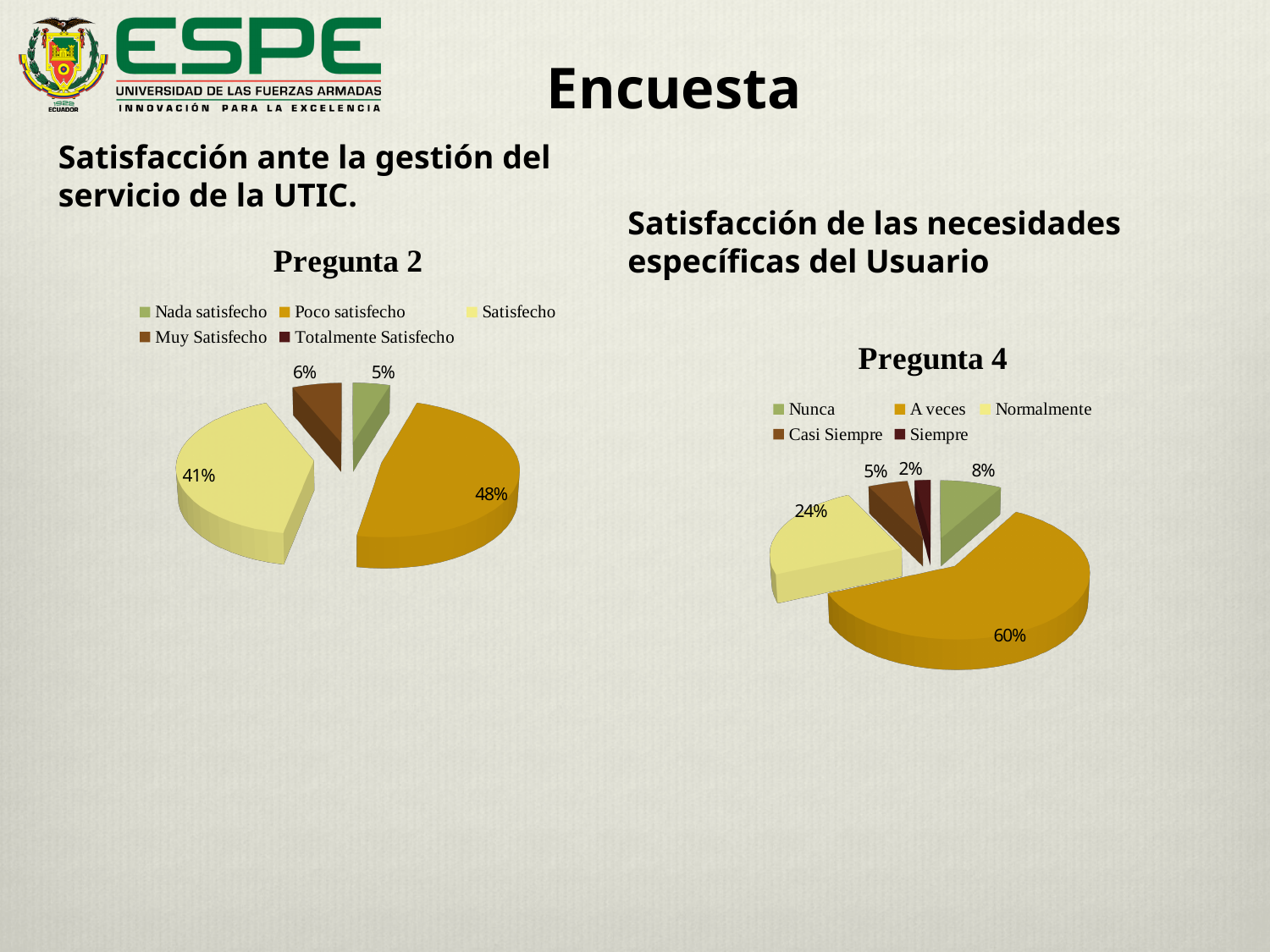
In the Pregunta 4 chart, what percentage is A veces? 60% In the Pregunta 2 chart, which is larger, Muy Satisfecho or Nada satisfecho? Muy Satisfecho How many entries does the legend of the Pregunta 4 chart list? 5 In the Pregunta 4 chart, what colour is the A veces slice? Orange In the Pregunta 4 chart, what percentage is Normalmente? 24% In the Pregunta 2 chart, what percentage is Satisfecho? 41% In the Pregunta 4 chart, which category has the smallest share? Siempre What type of chart is the Pregunta 2 chart? Pie chart In the Pregunta 2 chart, what percentage is Poco satisfecho? 48% In the Pregunta 4 chart, what is the difference between A veces and Nunca? 52% In the Pregunta 2 chart, which category has the largest share? Poco satisfecho In the Pregunta 2 chart, what is the difference between Poco satisfecho and Satisfecho? 7%